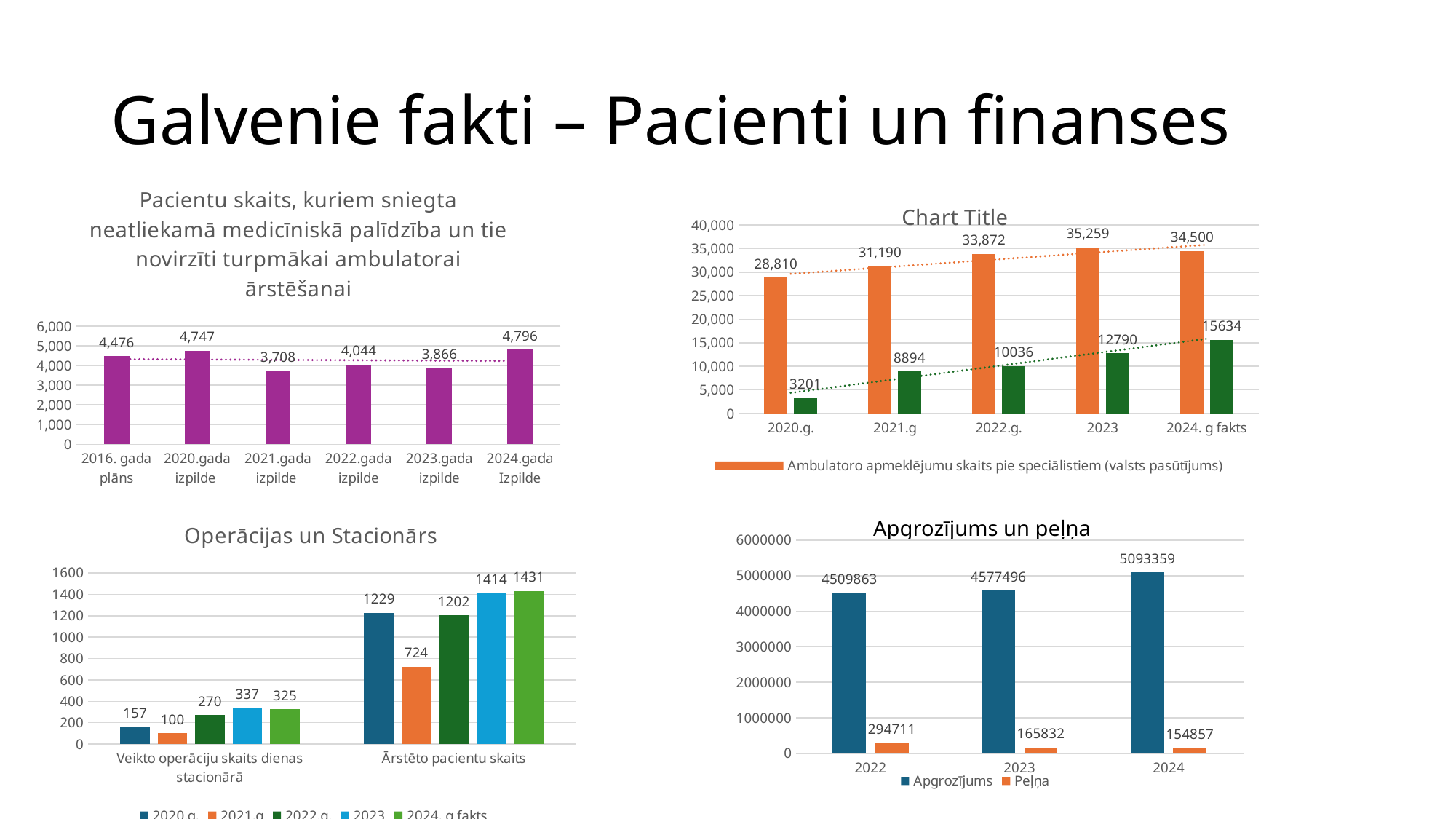
In the top-left chart about patients given emergency medical care, what is the value for '2024.gada Izpilde'? 4,796 In the chart 'Operācijas un Stacionārs', how many series does the legend list? 5 In the chart 'Apgrozījums un peļņa', does Peļņa rise or fall from 2022 to 2024? fall In the chart 'Apgrozījums un peļņa', what is the Apgrozījums value for 2024? 5093359 In the chart 'Operācijas un Stacionārs', what is the value for 2023 in the category 'Ārstēto pacientu skaits'? 1414 In the chart titled 'Chart Title' (top right), what is the difference between the green series values for 2024. g fakts and 2020.g.? 12433 In the chart 'Apgrozījums un peļņa', what is the difference between the Peļņa values for 2022 and 2023? 128879 In the top-left chart about patients given emergency medical care, how many categories are shown on the x axis? 6 In the chart titled 'Chart Title' (top right), what is the value of the orange series for 2022.g.? 33,872 In the chart 'Operācijas un Stacionārs', which series has the lowest value for 'Veikto operāciju skaits dienas stacionārā'? 2021.g In the top-left chart about patients given emergency medical care, which category has the lowest value? 2021.gada izpilde In the chart titled 'Chart Title' (top right), which category has the highest value for the orange series? 2023